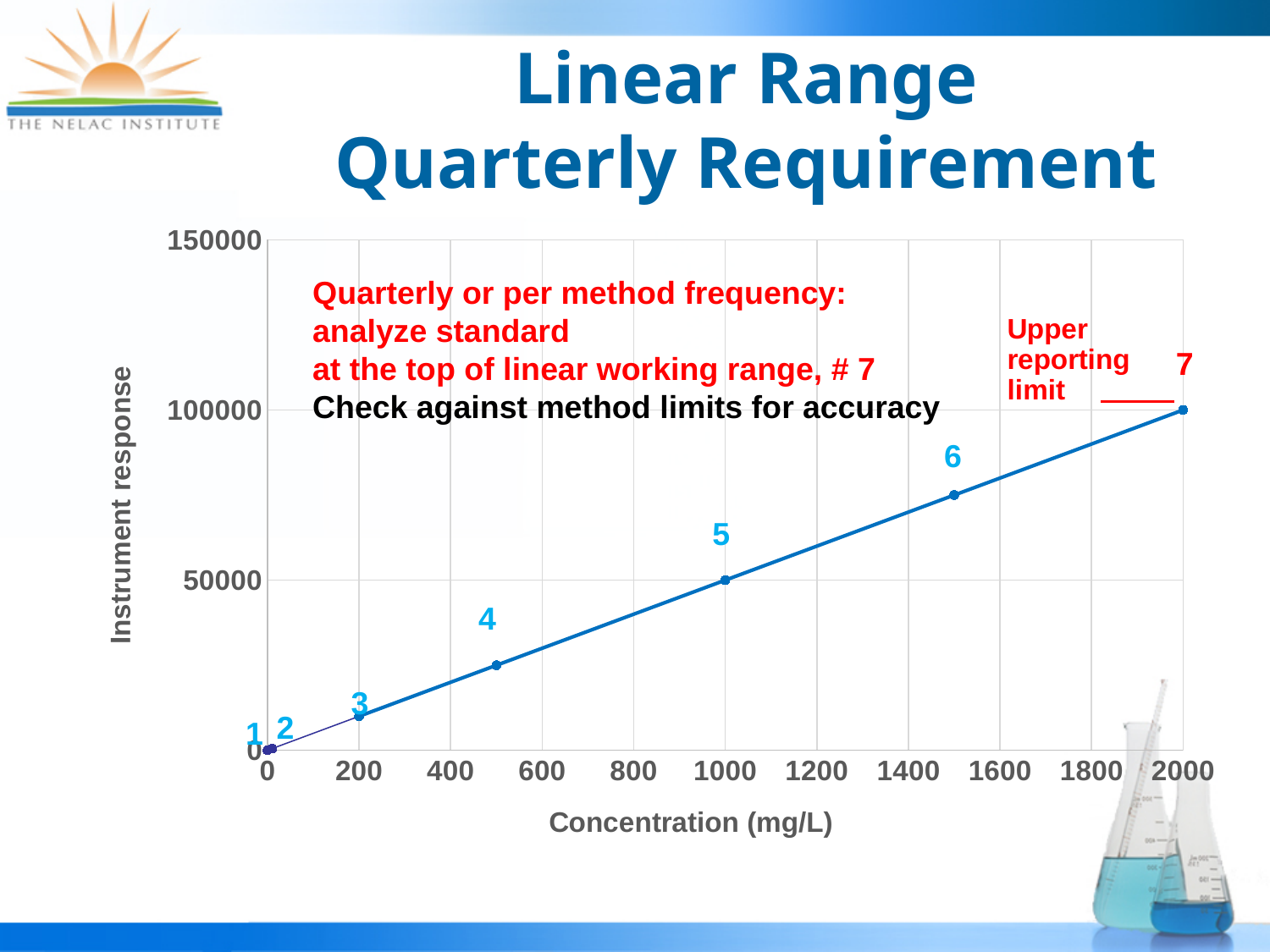
Which numbered point has the lowest instrument response? 1 What is the instrument response at point 7 (concentration 2000 mg/L)? 100000 What is the label of the x axis? Concentration (mg/L) What kind of chart is shown on the slide? line chart What is the instrument response at point 5 (concentration 1000 mg/L)? 50000 Which has the larger instrument response, point 3 or point 6? point 6 What is the label of the y axis? Instrument response How many numbered data points are plotted on the chart? 7 Is the instrument response at point 4 greater or less than 50000? less Which numbered point has the highest instrument response? 7 Is the instrument response at point 6 greater or less than 50000? greater Does the instrument response rise or fall as concentration increases along the x axis? rise